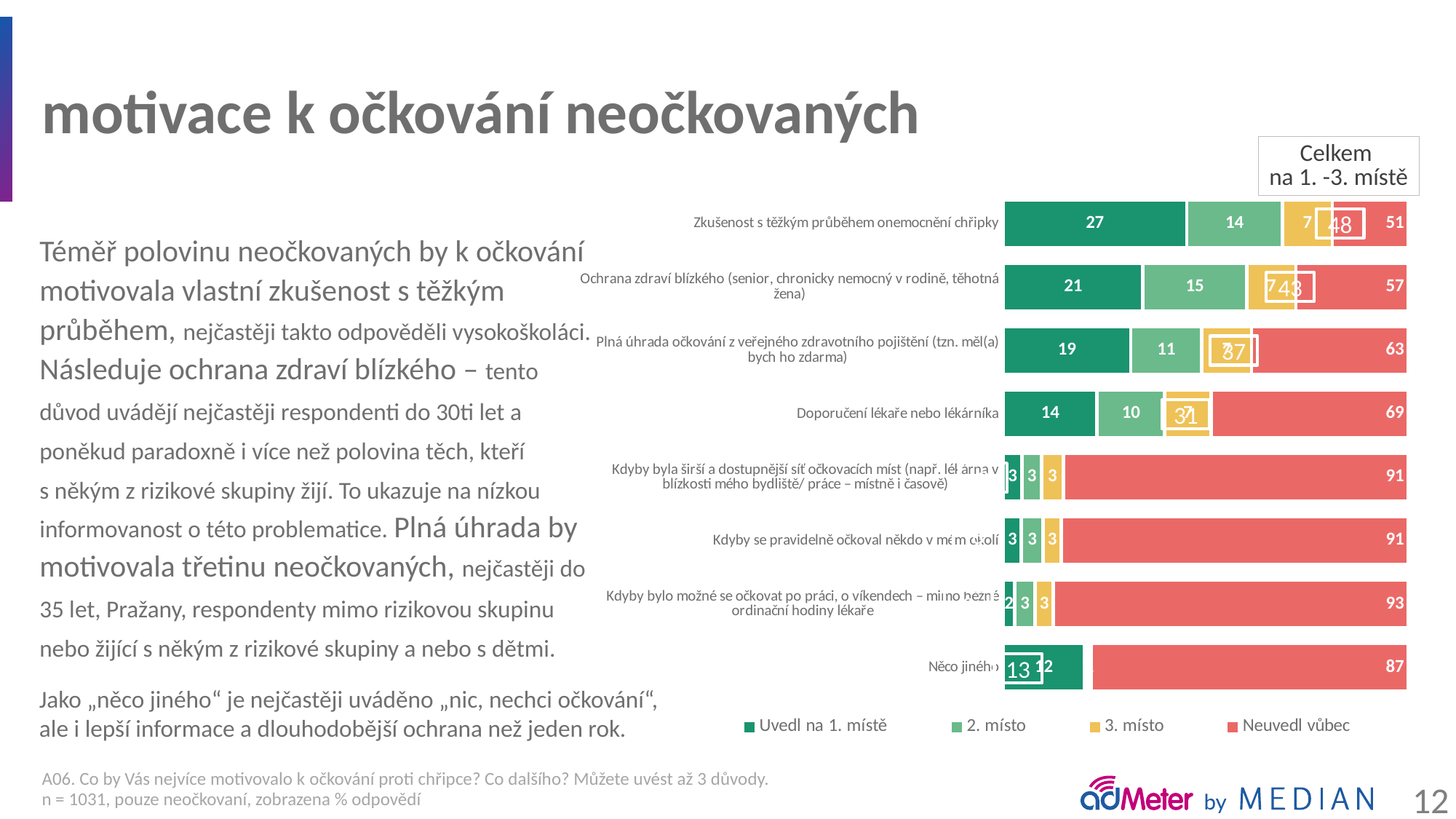
What is the difference between the 'Neuvedl vůbec' values for 'Doporučení lékaře nebo lékárníka' and 'Zkušenost s těžkým průběhem onemocnění chřipky'? 18 What kind of chart is shown on the slide? bar chart What is the 'Celkem na 1.-3. místě' value for 'Zkušenost s těžkým průběhem onemocnění chřipky'? 48 What is the 'Uvedl na 1. místě' value for 'Něco jiného'? 12 Which category has the highest 'Neuvedl vůbec' value? Kdyby bylo možné se očkovat po práci, o víkendech – mimo běžné ordinační hodiny lékaře What is the 'Neuvedl vůbec' value for 'Plná úhrada očkování z veřejného zdravotního pojištění'? 63 What is the 'Uvedl na 1. místě' value for 'Zkušenost s těžkým průběhem onemocnění chřipky'? 27 How many categories (motivation reasons) does the chart show? 8 Which is larger: the 'Uvedl na 1. místě' value for 'Ochrana zdraví blízkého' or for 'Plná úhrada očkování z veřejného zdravotního pojištění'? Ochrana zdraví blízkého Which category has the lowest 'Neuvedl vůbec' value? Zkušenost s těžkým průběhem onemocnění chřipky What is the '2. místo' value for 'Ochrana zdraví blízkého'? 15 How many series does the legend list? 4